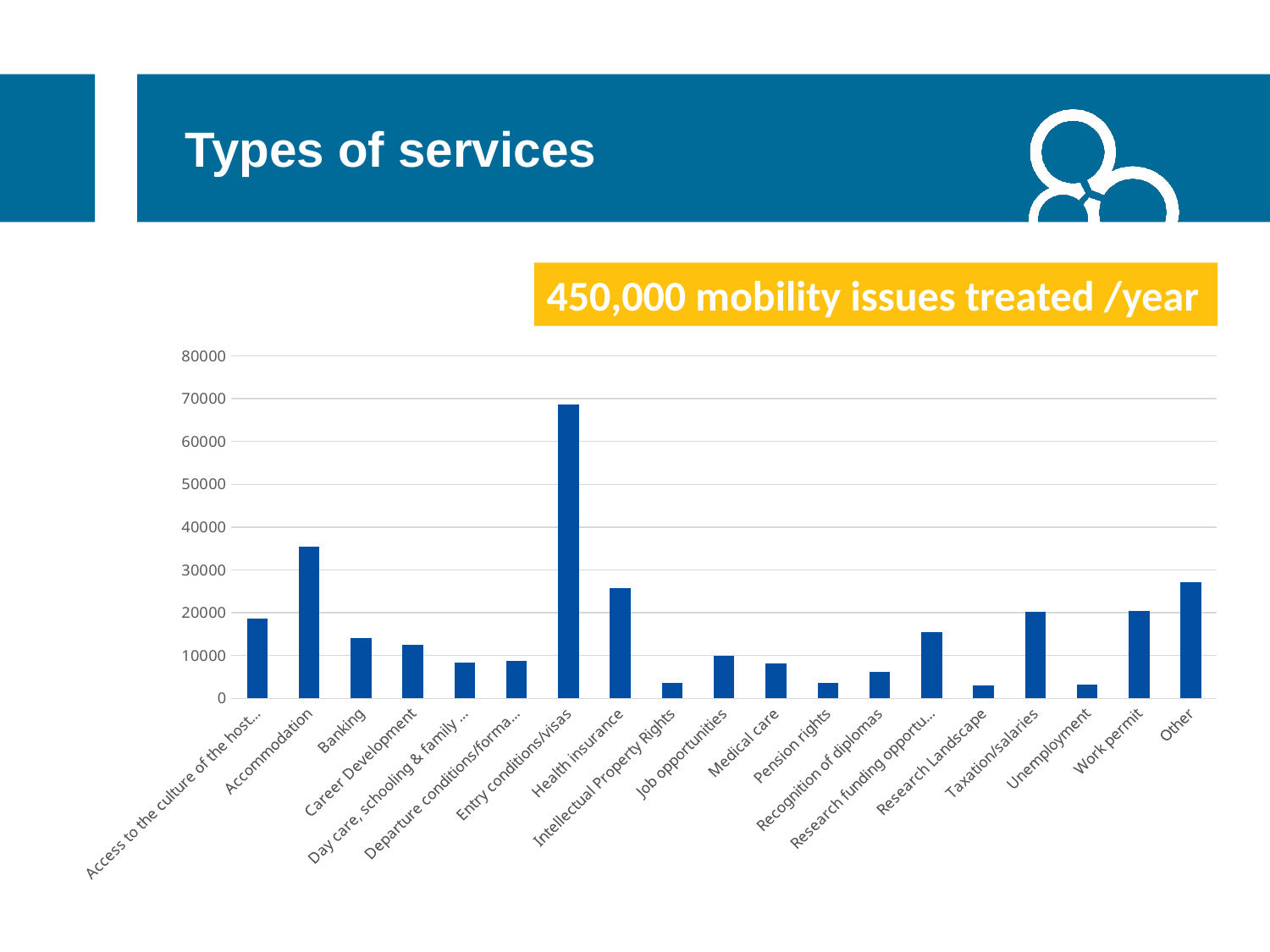
How many categories are plotted along the x axis of the chart? 19 Is the value for Other greater or less than 30000? less What is the title of the slide containing the chart? Types of services Is the value for Entry conditions/visas greater or less than 60000? greater Which has the larger value, Other or Work permit? Other Which has the larger value, Accommodation or Health insurance? Accommodation Is the value for Health insurance greater or less than 20000? greater Which category has the highest value in the chart? Entry conditions/visas Which has the larger value, Job opportunities or Recognition of diplomas? Job opportunities What kind of chart is shown on the slide? bar chart